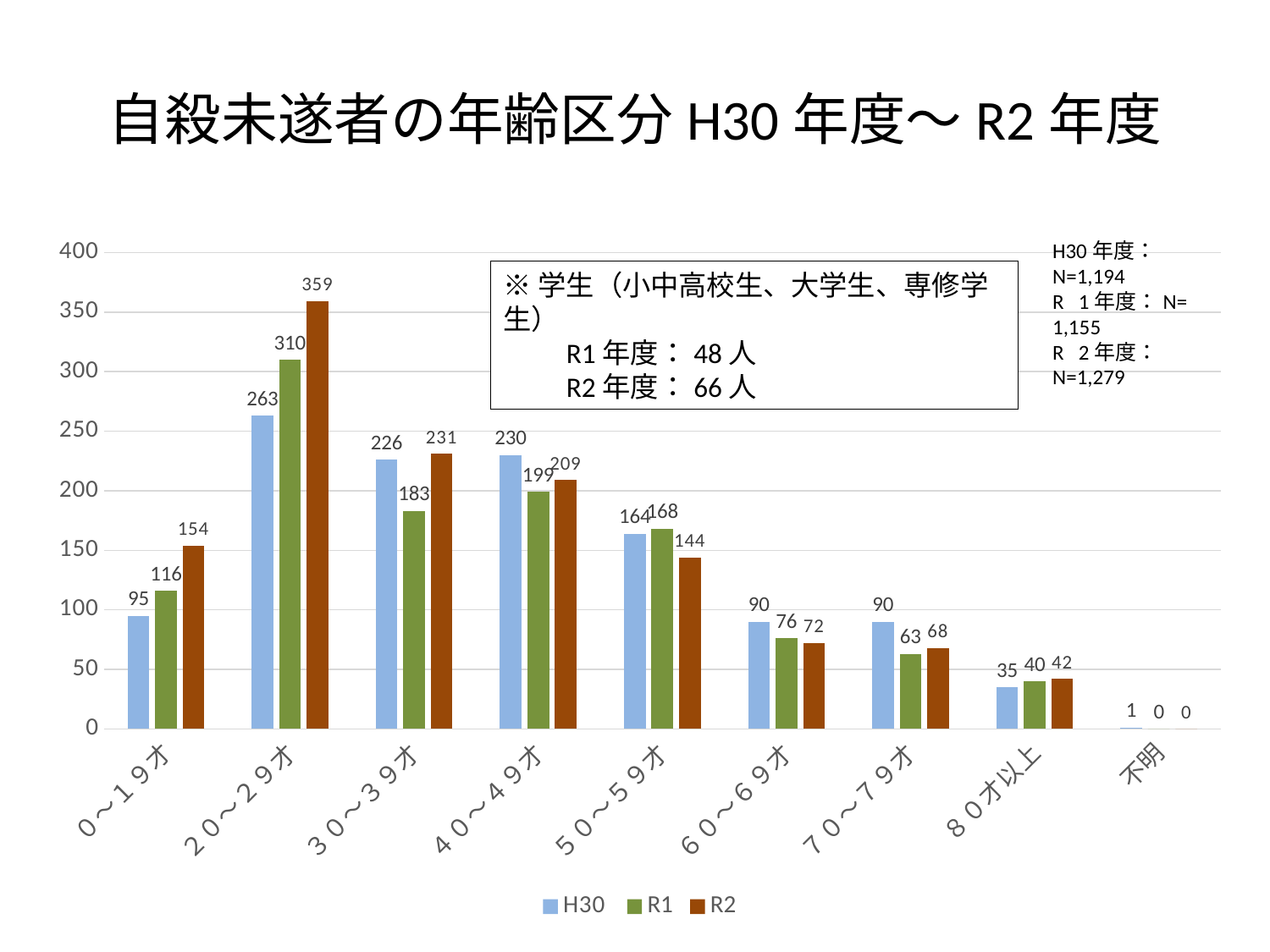
What is the R1 value for the 30～39才 age group? 183 Which age group has the lowest H30 value? 不明 What is the R2 value for the 20～29才 age group? 359 Which is larger for the 50～59才 age group, the H30 value or the R2 value? H30 Which age group has the highest R2 value? 20～29才 What is the title of the chart on the slide? 自殺未遂者の年齢区分 H30 年度～ R2 年度 What is the H30 value for the 40～49才 age group? 230 How many age categories are shown on the x axis? 9 How many series does the legend list? 3 What is the difference between the R2 and H30 values for the 0～19才 age group? 59 Is the R1 value for the 20～29才 age group greater or less than 300? greater What kind of chart is shown on the slide? bar chart